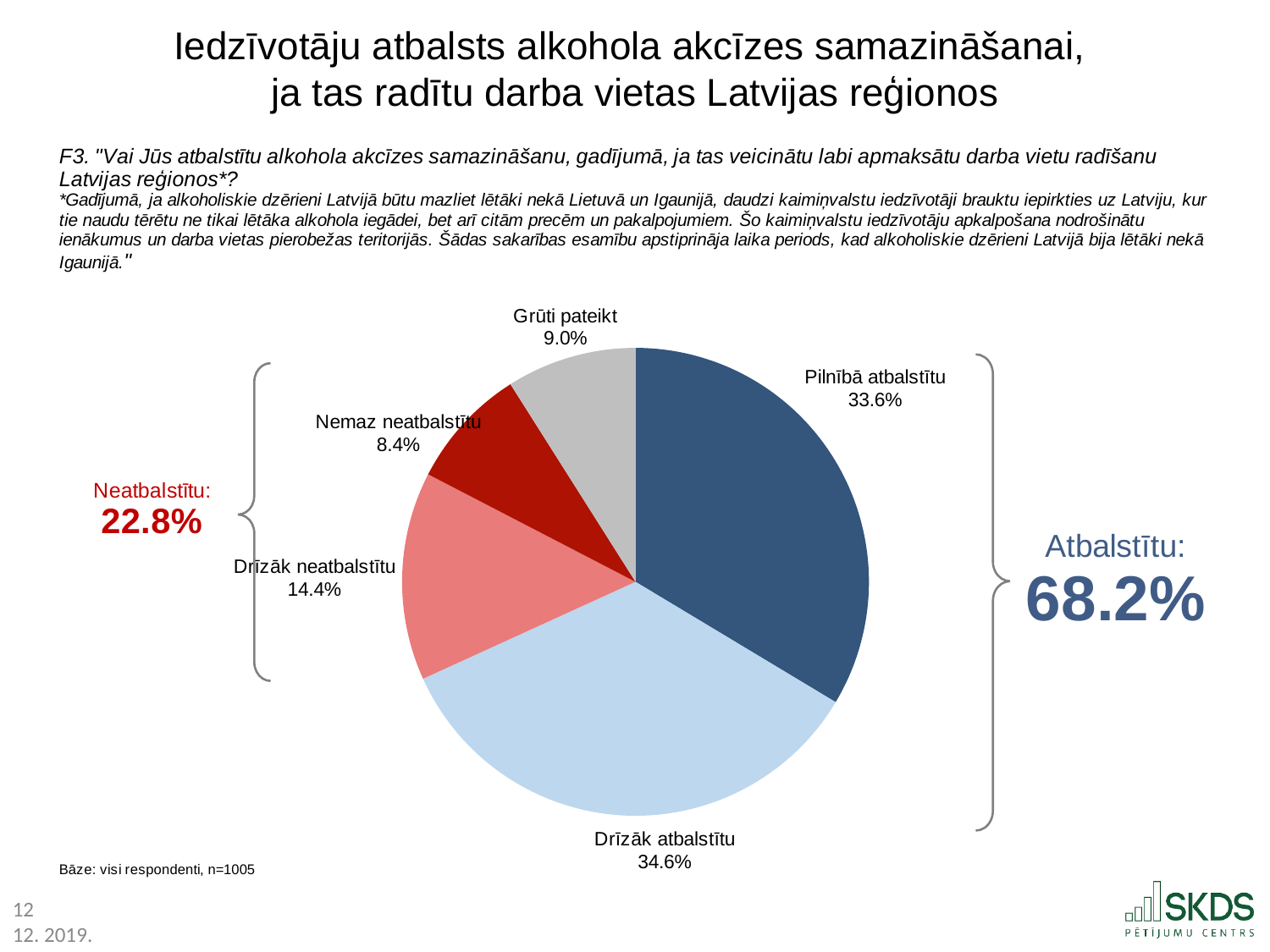
What is the value for "Drīzāk atbalstītu"? 34.6% What combined share is shown for "Atbalstītu" (Pilnībā atbalstītu plus Drīzāk atbalstītu)? 68.2% Which slice of the pie is the smallest? Nemaz neatbalstītu Which slice of the pie is the largest? Drīzāk atbalstītu What is the value for "Nemaz neatbalstītu"? 8.4% What is the difference between "Drīzāk atbalstītu" and "Drīzāk neatbalstītu"? 20.2% What is the value for "Pilnībā atbalstītu"? 33.6% What is the value for "Drīzāk neatbalstītu"? 14.4% What kind of chart is shown on the slide? pie chart What combined share is shown for "Neatbalstītu" (Drīzāk neatbalstītu plus Nemaz neatbalstītu)? 22.8% How many slices does the pie chart have? 5 What is the value for "Grūti pateikt"? 9.0%